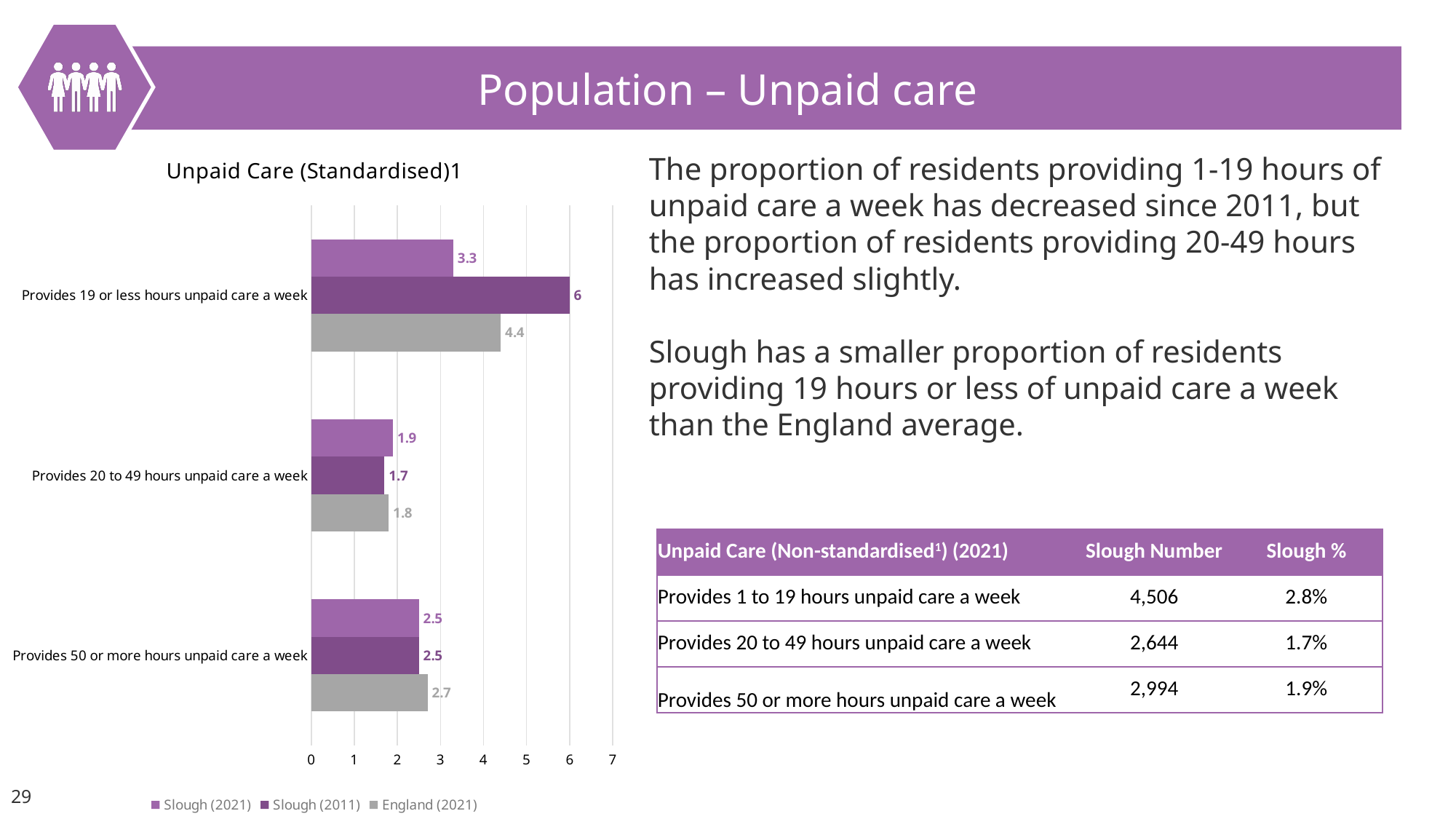
What is the England (2021) value for 'Provides 20 to 49 hours unpaid care a week'? 1.8 What is the difference between the Slough (2011) and Slough (2021) values for 'Provides 19 or less hours unpaid care a week'? 2.7 What is the England (2021) value for 'Provides 50 or more hours unpaid care a week'? 2.7 How many series does the legend list? 3 What is the title of the chart? Unpaid Care (Standardised)1 For 'Provides 19 or less hours unpaid care a week', which is larger: the Slough (2021) value or the England (2021) value? England (2021) What is the Slough (2011) value for 'Provides 19 or less hours unpaid care a week'? 6 Which category has the highest Slough (2011) value? Provides 19 or less hours unpaid care a week How many categories are shown on the chart? 3 What is the Slough (2021) value for 'Provides 19 or less hours unpaid care a week'? 3.3 What kind of chart is shown on the slide? Bar chart Which category has the lowest Slough (2021) value? Provides 20 to 49 hours unpaid care a week